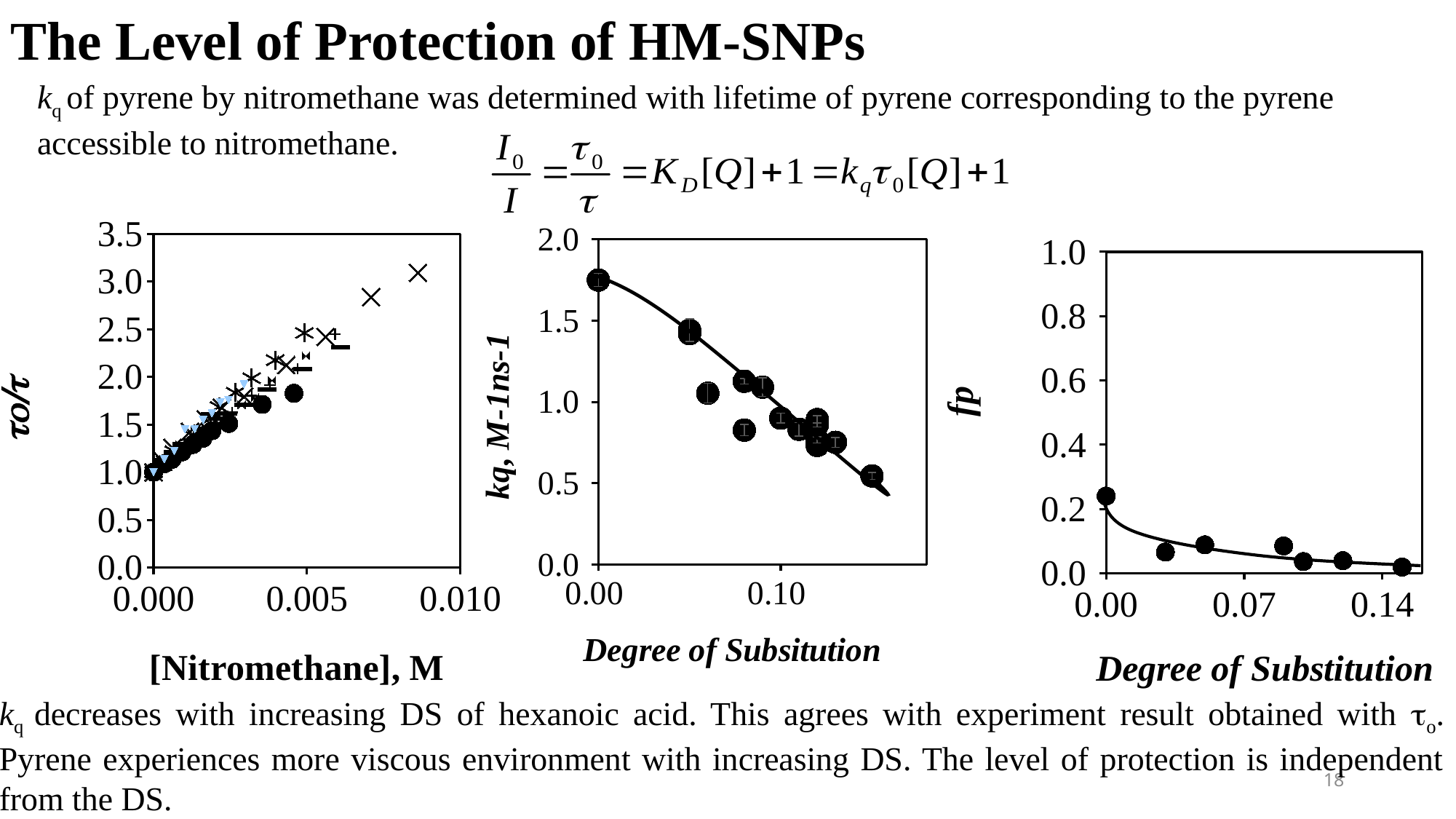
What is the x-axis label of the left chart? [Nitromethane], M In the middle chart, do the kq values rise or fall as the Degree of Substitution increases? fall In the middle chart, is the kq value at the highest Degree of Substitution plotted greater or less than 1.0? less What kind of chart is the middle chart (kq versus Degree of Substitution)? scatter chart In the middle chart, is the kq value at a Degree of Substitution of 0.00 greater or less than 1.5? greater How many charts are shown on the slide? 3 In the right chart, is the fp value at a Degree of Substitution of 0.00 greater or less than 0.4? less In the right chart, do the fp values rise or fall as the Degree of Substitution increases? fall In the right chart, which Degree of Substitution has the highest fp value? 0.00 In the left chart, do the τo/τ values rise or fall as [Nitromethane] increases? rise What is the y-axis label of the right chart? fp